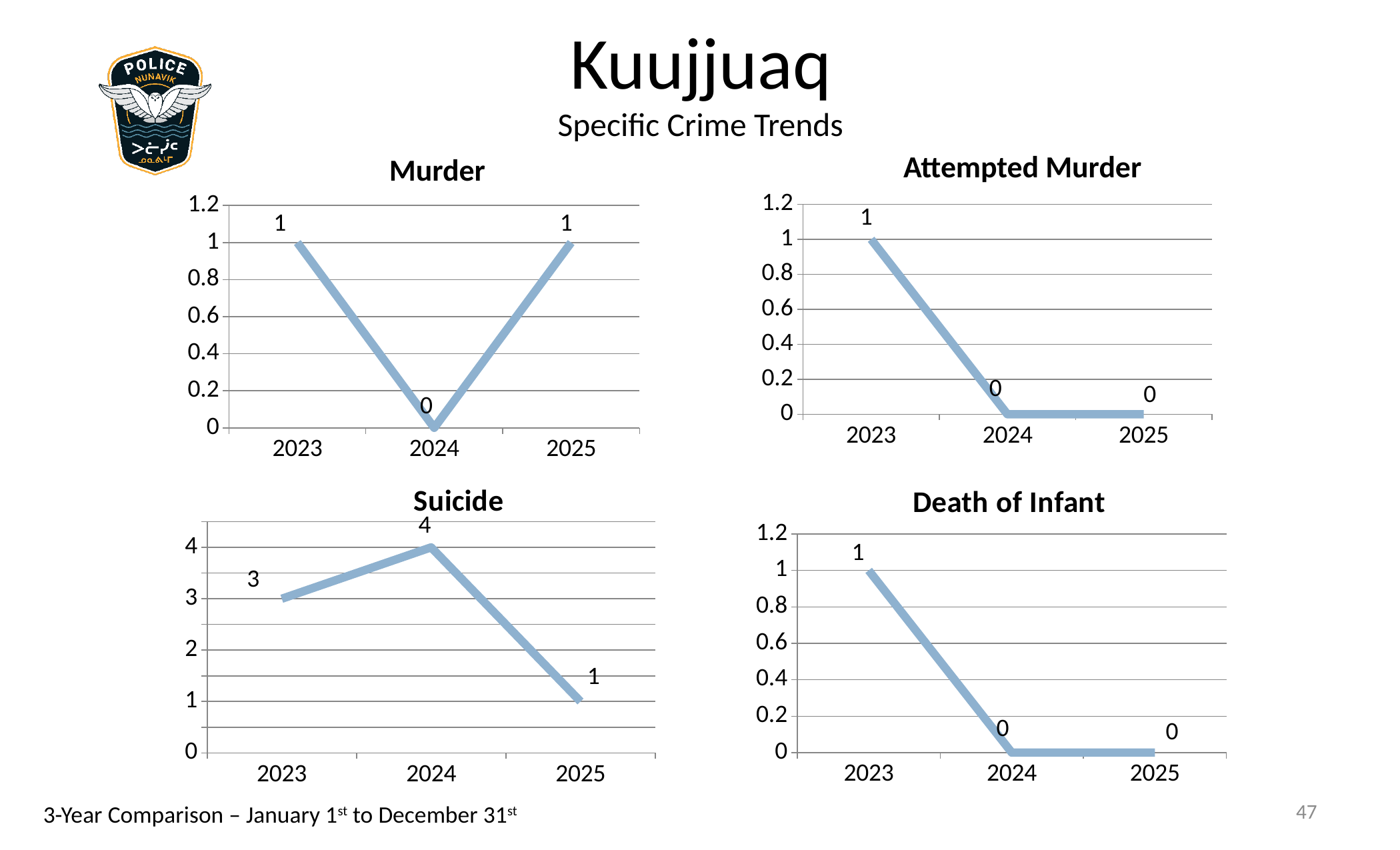
In the Murder chart, what is the value for 2025? 1 How many years are plotted in the Attempted Murder chart? 3 In the Suicide chart, which is larger, the value for 2023 or the value for 2025? 2023 What kind of chart is the Death of Infant chart? Line chart In the Suicide chart, what is the value for 2024? 4 In the Suicide chart, which year has the highest value? 2024 In the Murder chart, what is the value for 2024? 0 In the Suicide chart, which year has the lowest value? 2025 In the Attempted Murder chart, do the values rise or fall from 2023 to 2024? Fall In the Death of Infant chart, what is the value for 2024? 0 In the Suicide chart, what is the difference between the 2024 and 2025 values? 3 In the Attempted Murder chart, what is the value for 2023? 1